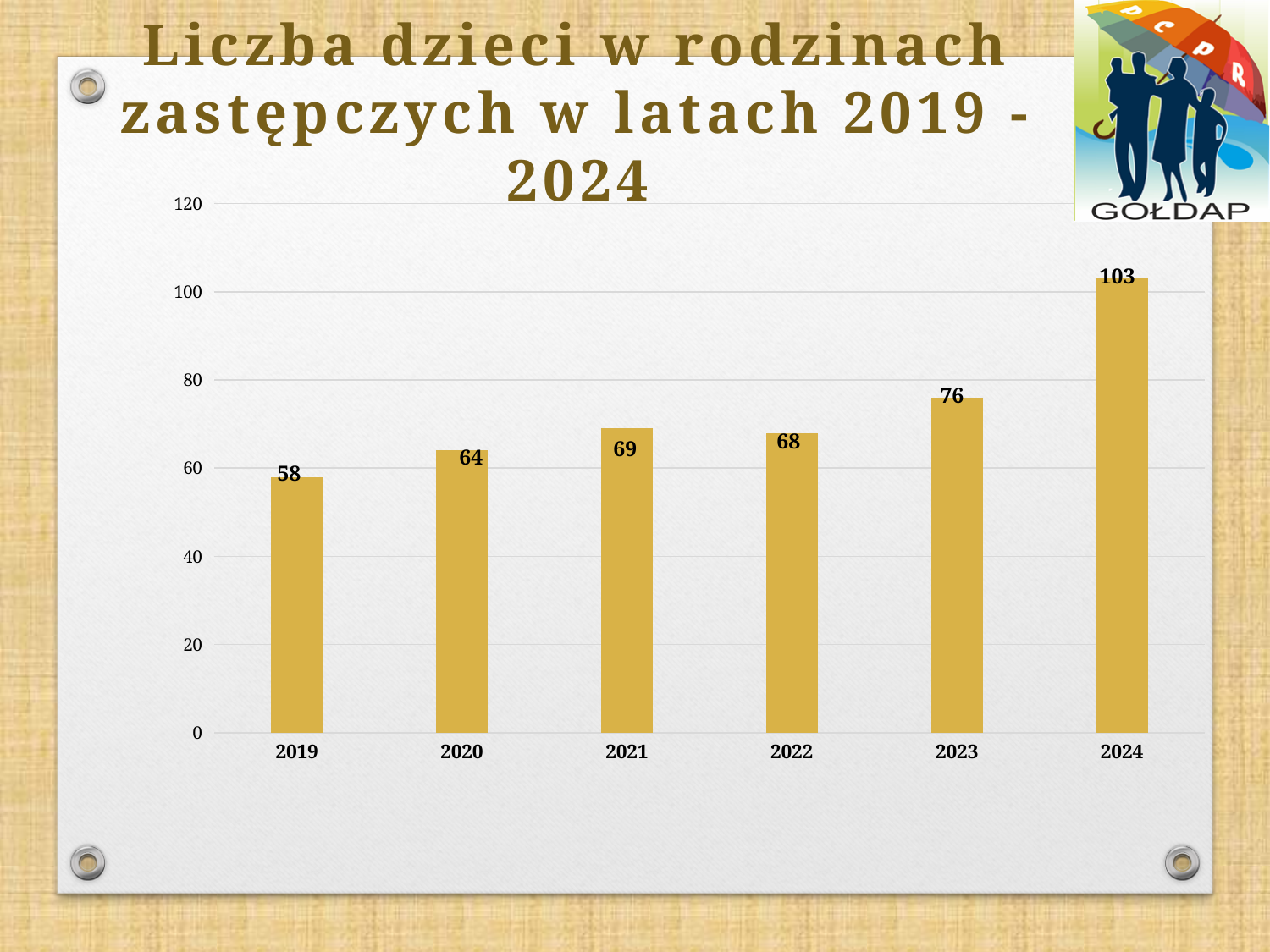
What is the value for 2024? 103 What kind of chart is shown on the slide? bar chart What is the title of the chart? Liczba dzieci w rodzinach zastępczych w latach 2019 - 2024 What is the value for 2019? 58 Which year has the highest value? 2024 Is the value for 2023 greater or less than 80? less How many years are shown on the x axis? 6 Which year has the lowest value? 2019 What is the difference between the values for 2024 and 2023? 27 Which is larger, the value for 2021 or the value for 2022? 2021 What is the difference between the values for 2020 and 2019? 6 What is the value for 2022? 68